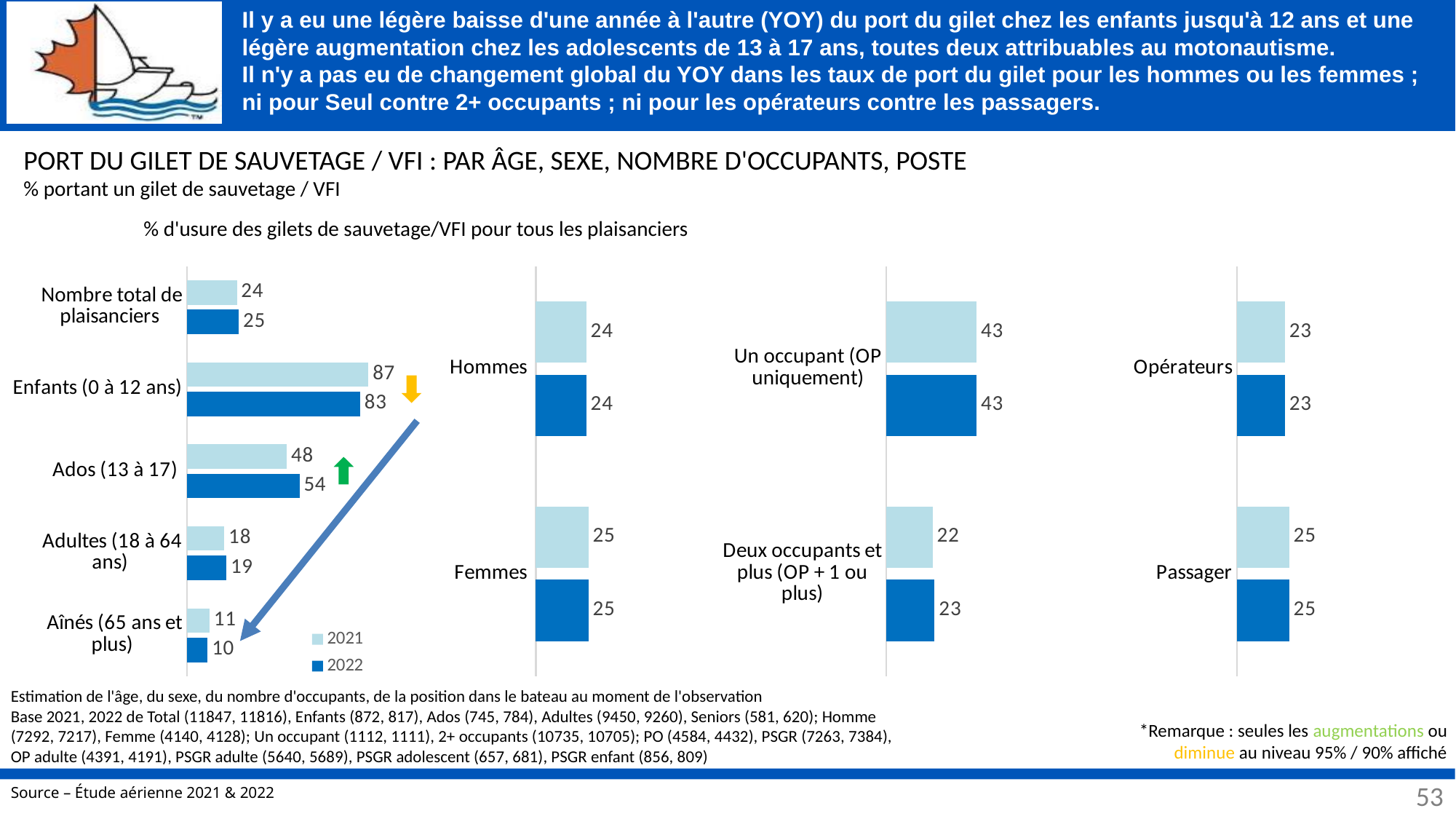
In the rightmost chart (Opérateurs / Passager), what is the 2022 value for Passager? 25 In the leftmost chart (by age group), what is the 2022 value for Enfants (0 à 12 ans)? 83 In the leftmost chart (by age group), what is the 2021 value for Ados (13 à 17)? 48 In the third chart from the left (number of occupants), which category has the larger 2022 value: Un occupant (OP uniquement) or Deux occupants et plus (OP + 1 ou plus)? Un occupant (OP uniquement) In the third chart from the left (number of occupants), what is the 2021 value for Un occupant (OP uniquement)? 43 In the leftmost chart (by age group), which category has the highest 2021 value? Enfants (0 à 12 ans) What type of chart is the leftmost chart (by age group)? bar chart In the leftmost chart (by age group), what is the difference between the 2021 and 2022 values for Ados (13 à 17)? 6 How many series does the legend list on the slide? 2 In the second chart from the left (Hommes / Femmes), what is the 2022 value for Femmes? 25 In the leftmost chart (by age group), which category has the lowest 2022 value? Aînés (65 ans et plus) In the leftmost chart (by age group), how many age categories are shown? 5